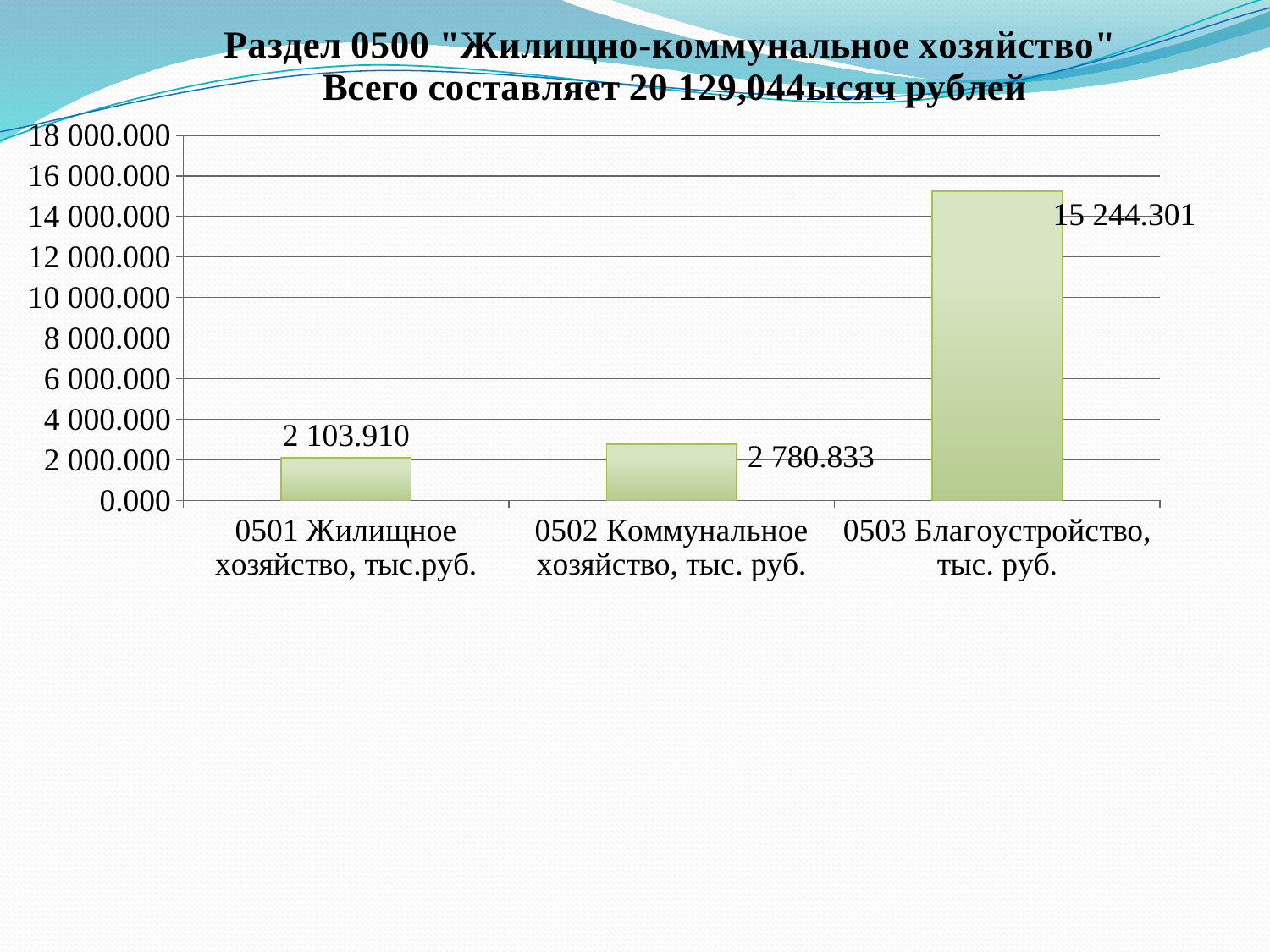
What kind of chart is shown on the slide? bar chart How many categories are shown in the chart? 3 Is the value for 0503 Благоустройство greater or less than 14 000.000? greater What total amount does the slide title state for Раздел 0500? 20 129,044 тысяч рублей What is the value for 0503 Благоустройство, тыс. руб.? 15 244.301 What is the difference between the values for 0502 Коммунальное хозяйство and 0501 Жилищное хозяйство? 676.923 Which is larger, the value for 0501 Жилищное хозяйство or the value for 0502 Коммунальное хозяйство? 0502 Коммунальное хозяйство What is the value for 0502 Коммунальное хозяйство, тыс. руб.? 2 780.833 What is the difference between the values for 0503 Благоустройство and 0502 Коммунальное хозяйство? 12 463.468 Which category has the highest value? 0503 Благоустройство, тыс. руб. Which category has the lowest value? 0501 Жилищное хозяйство, тыс.руб. What is the value for 0501 Жилищное хозяйство, тыс.руб.? 2 103.910